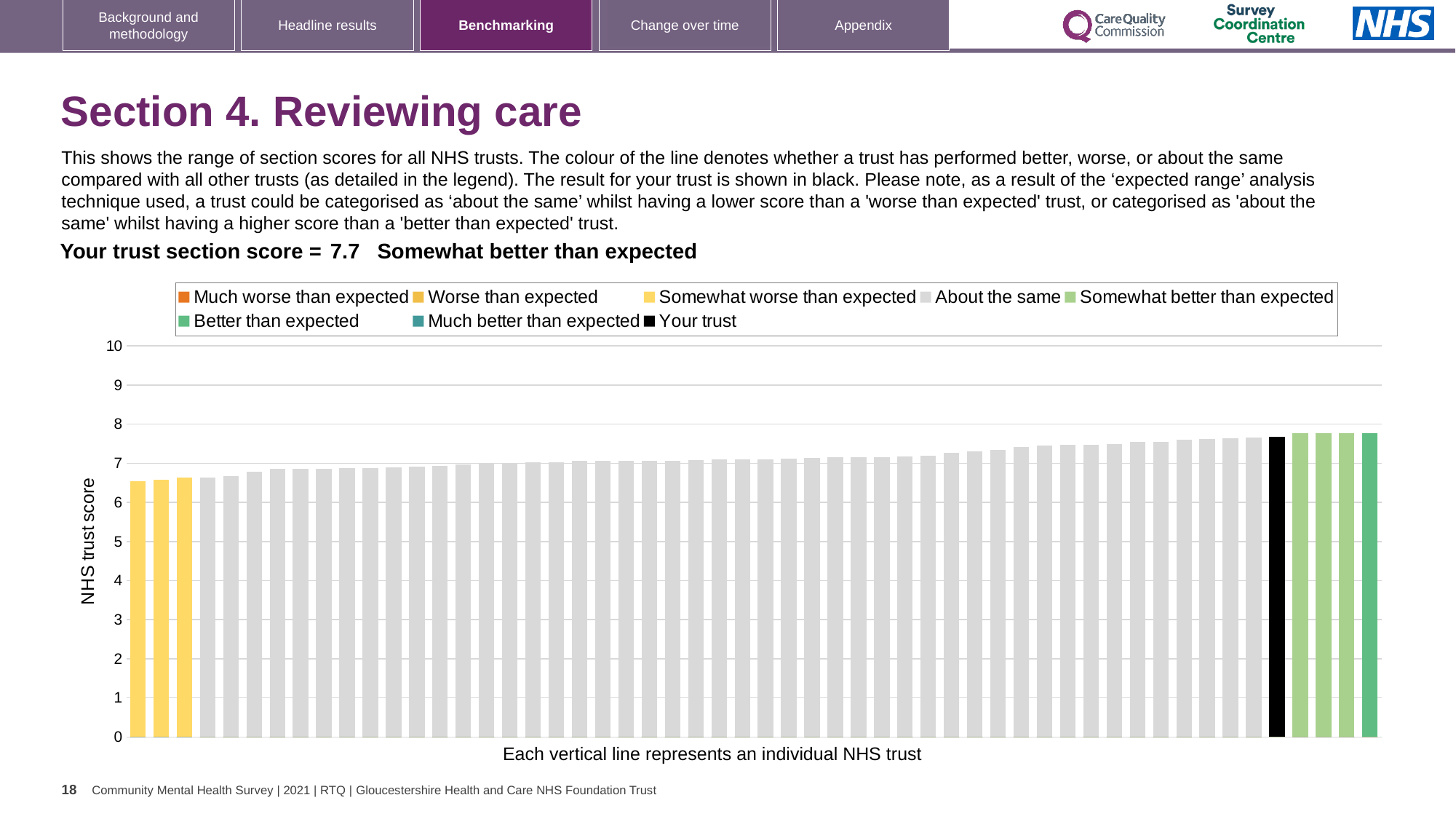
Is the value of the highest bar greater or less than 8? less What is the label on the vertical axis of the chart? NHS trust score How many entries does the chart legend list? 8 How many bars are to the right of the black 'Your trust' bar? 4 What kind of chart is shown on the slide? bar chart What is the section score for your trust? 7.7 How many bars are coloured yellow (Somewhat worse than expected)? 3 Is the value of the lowest bar greater or less than 7? less Which category is your trust's section score placed in? Somewhat better than expected Is the value for your trust greater or less than 7? greater Do the bar values rise or fall from left to right along the x axis? rise What is the highest value shown on the vertical axis? 10